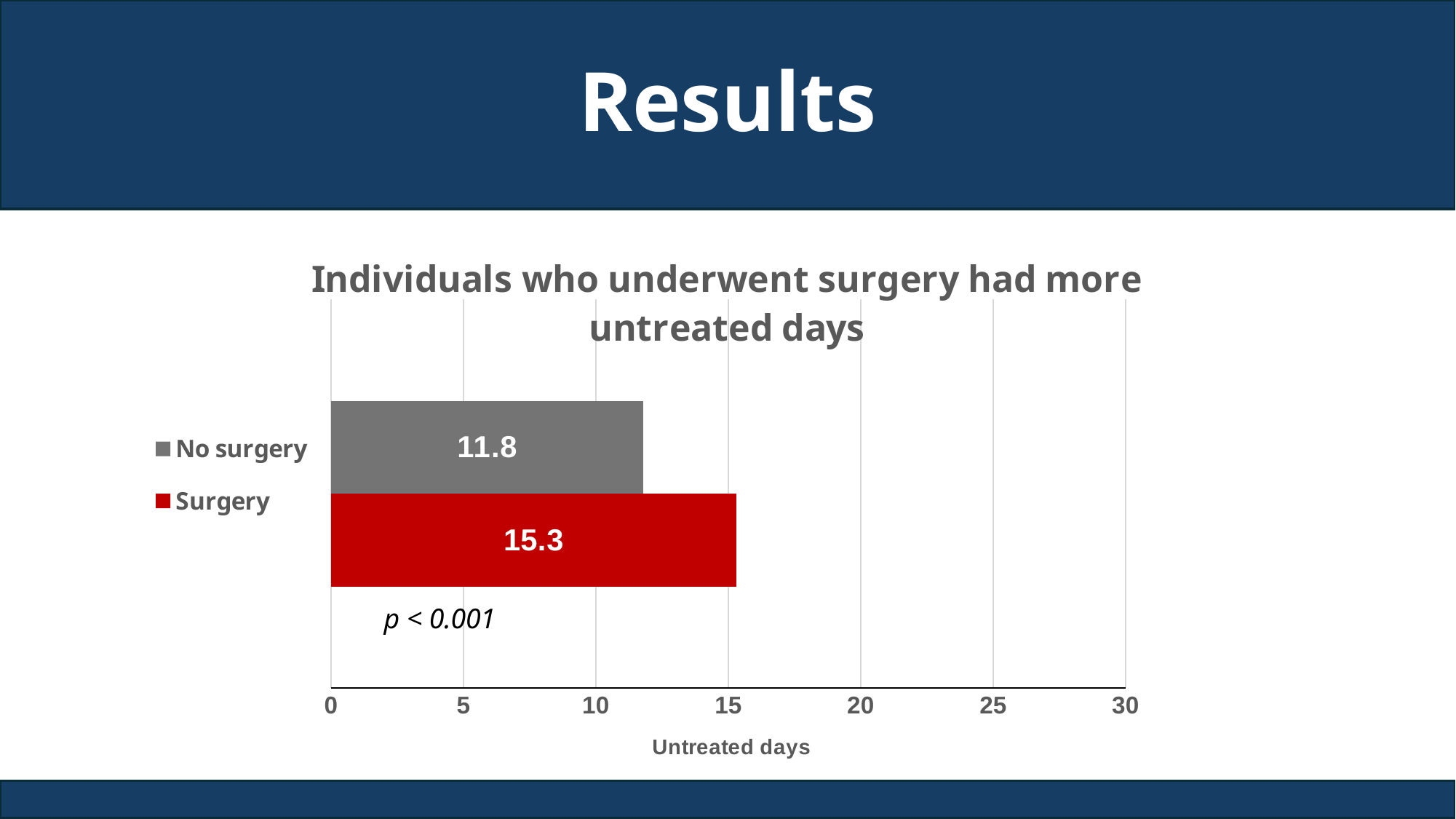
Which group has the higher number of untreated days? Surgery Is the value for Surgery larger or smaller than the value for No surgery? larger What is the label of the horizontal axis? Untreated days What is the title of the chart? Individuals who underwent surgery had more untreated days Which group has the lower number of untreated days? No surgery What is the value for No surgery? 11.8 How many series does the legend list? 2 Is the value for No surgery greater or less than 10? greater Is the value for Surgery greater or less than 20? less What is the difference in untreated days between Surgery and No surgery? 3.5 What kind of chart is shown? bar chart What is the value for Surgery? 15.3